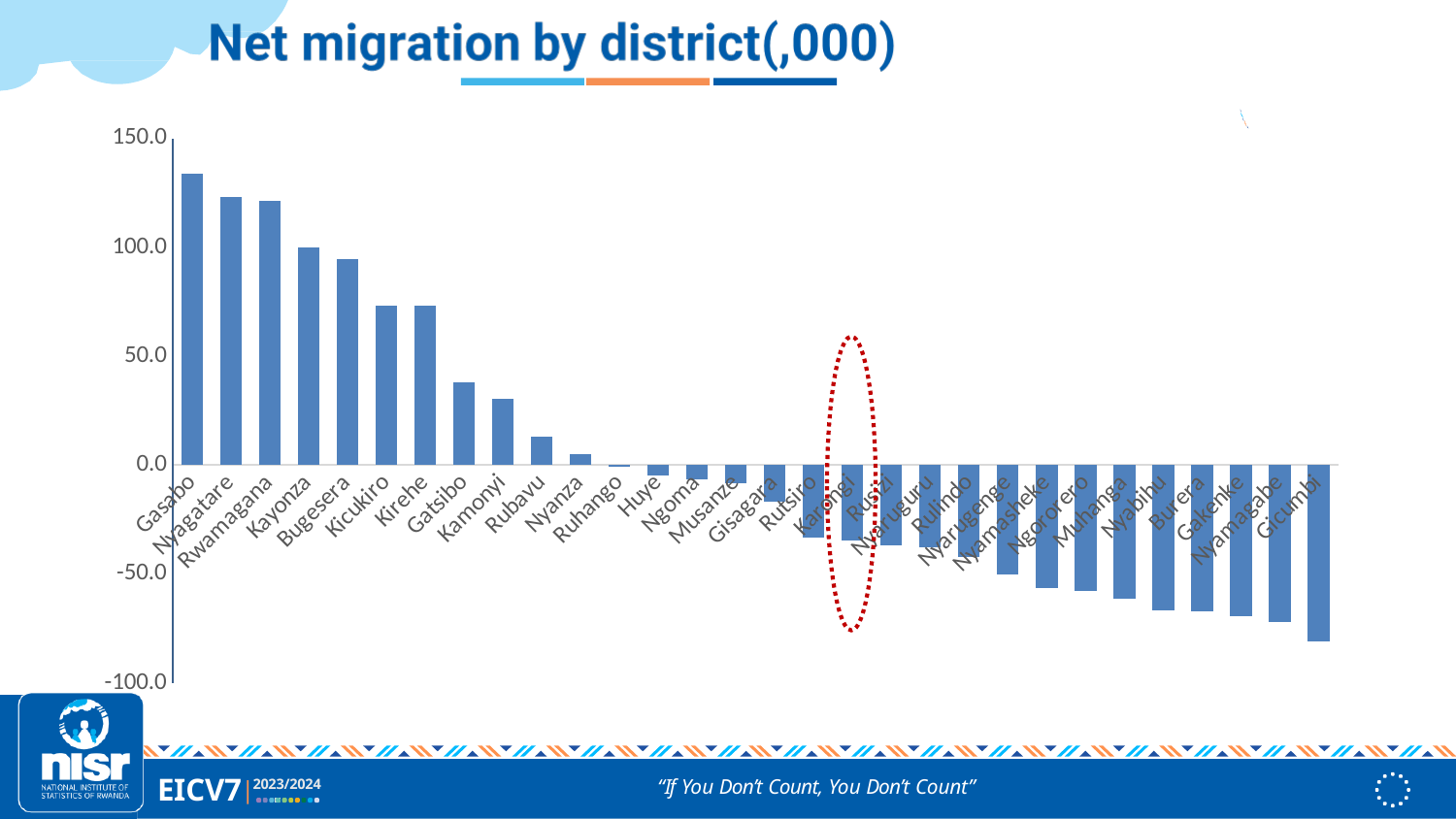
Is the value for Bugesera greater or less than 100.0? less What kind of chart is shown on the slide? bar chart Which district has the highest net migration? Gasabo Is the value for Gasabo greater or less than 100.0? greater What is the title of the chart? Net migration by district(,000) Is the value for Gatsibo greater or less than 50.0? less Do the values rise or fall moving from left to right along the x axis? fall How many districts are plotted in the chart? 30 Which district has the lowest net migration? Gicumbi Which has the larger net migration, Gasabo or Kayonza? Gasabo